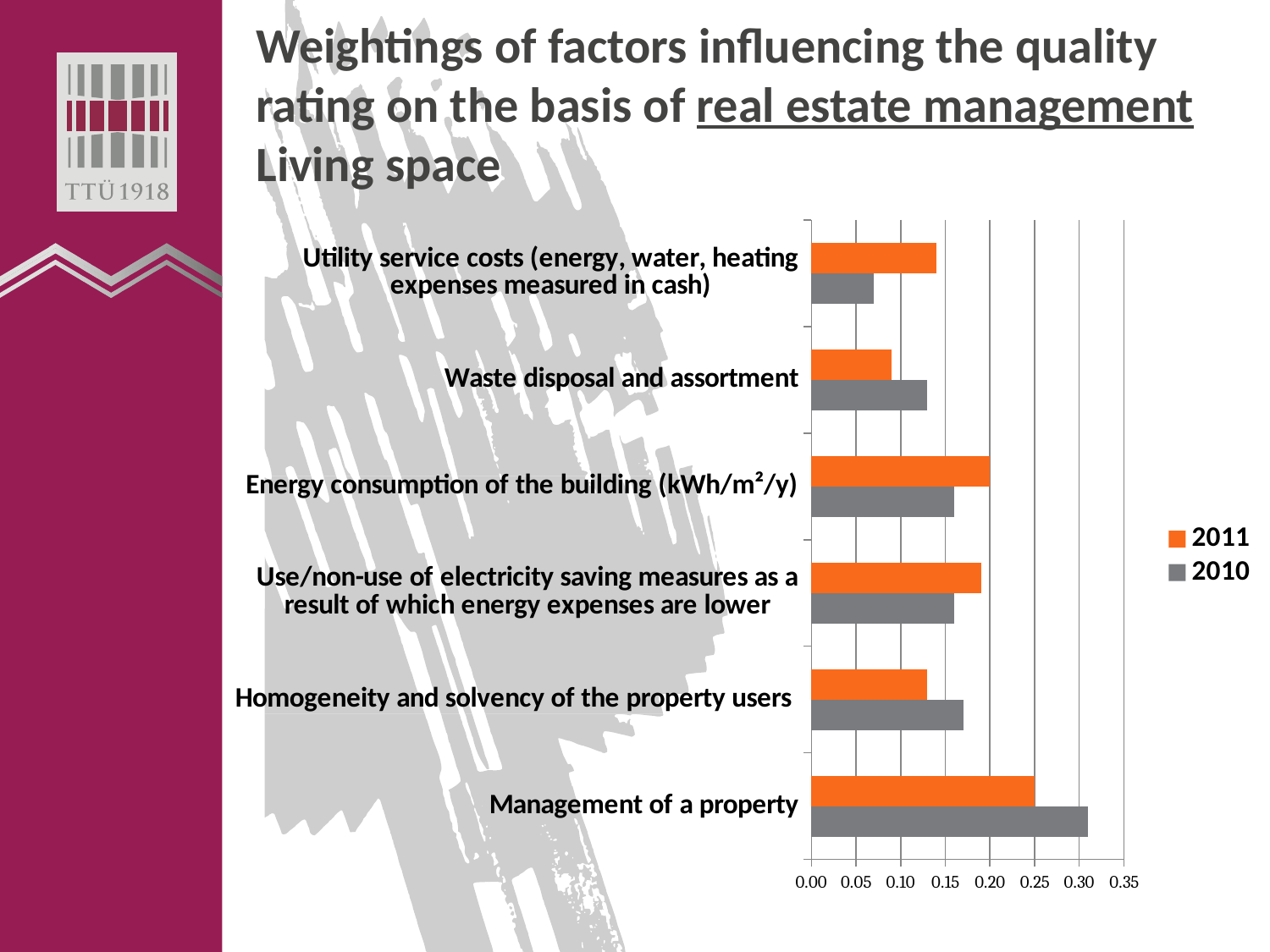
Which factor has the highest weighting for 2011? Management of a property What kind of chart is shown on the slide? bar chart Which factor has the lowest weighting for 2010? Utility service costs (energy, water, heating expenses measured in cash) For Utility service costs, which year has the larger weighting, 2010 or 2011? 2011 How many series does the legend list? 2 Which factor has the lowest weighting for 2011? Waste disposal and assortment Which factor has the highest weighting for 2010? Management of a property For Management of a property, which year has the larger weighting, 2010 or 2011? 2010 Which colour represents the 2011 series in the legend? orange Is the 2010 value for Utility service costs greater or less than 0.10? less How many categories (factors) are plotted on the chart? 6